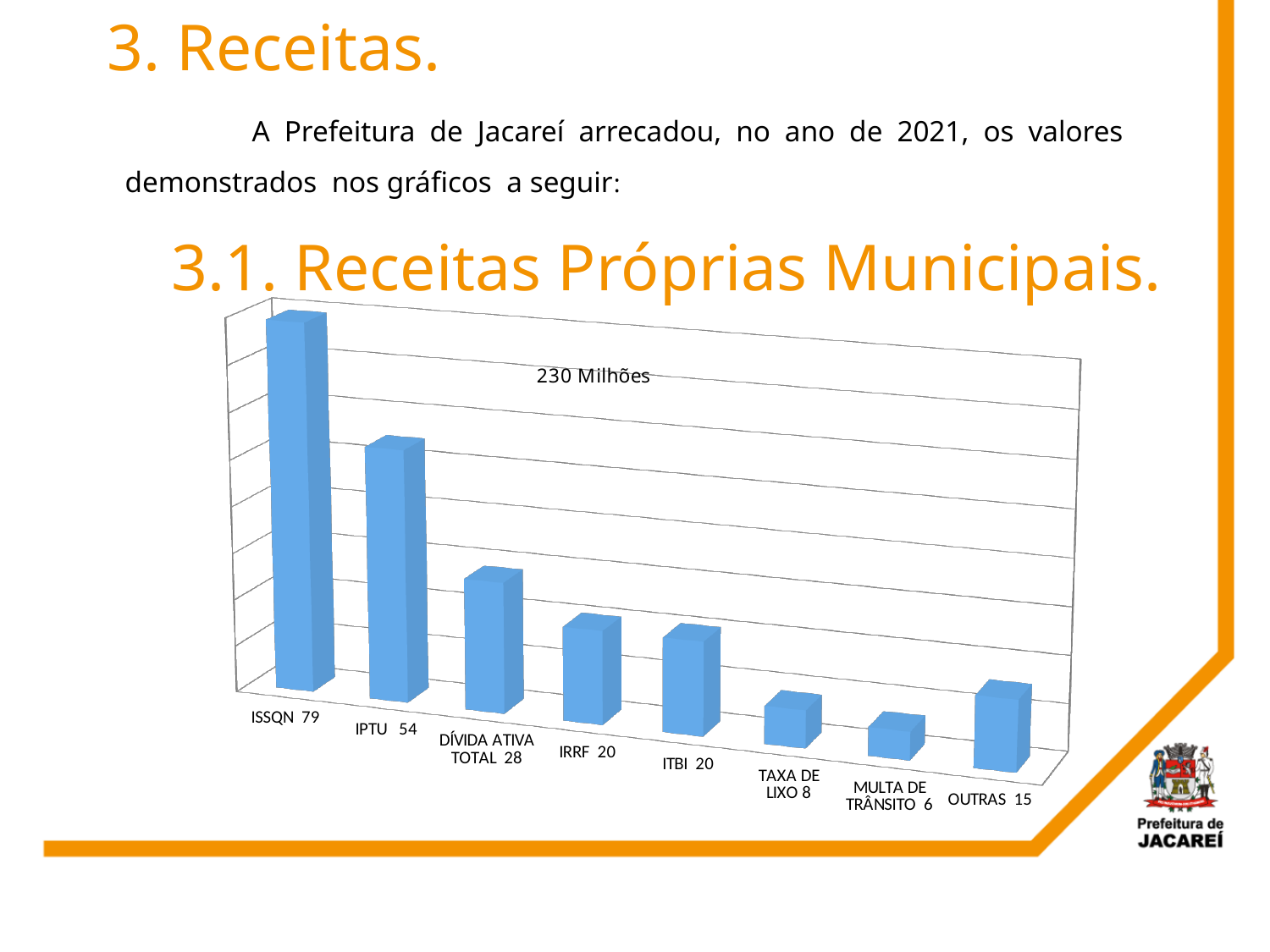
What value is shown for IPTU? 54 What is the difference between the values for ISSQN and IPTU? 25 What text is shown as the title inside the chart area? 230 Milhões What kind of chart is shown on the slide? Bar chart Which is larger, the value for OUTRAS or the value for TAXA DE LIXO? OUTRAS What value is shown for OUTRAS? 15 What value is shown for DÍVIDA ATIVA TOTAL? 28 Which category has the lowest value? MULTA DE TRÂNSITO Which category has the highest value? ISSQN What value is shown for TAXA DE LIXO? 8 How many categories are shown in the chart? 8 What value is shown for ISSQN? 79